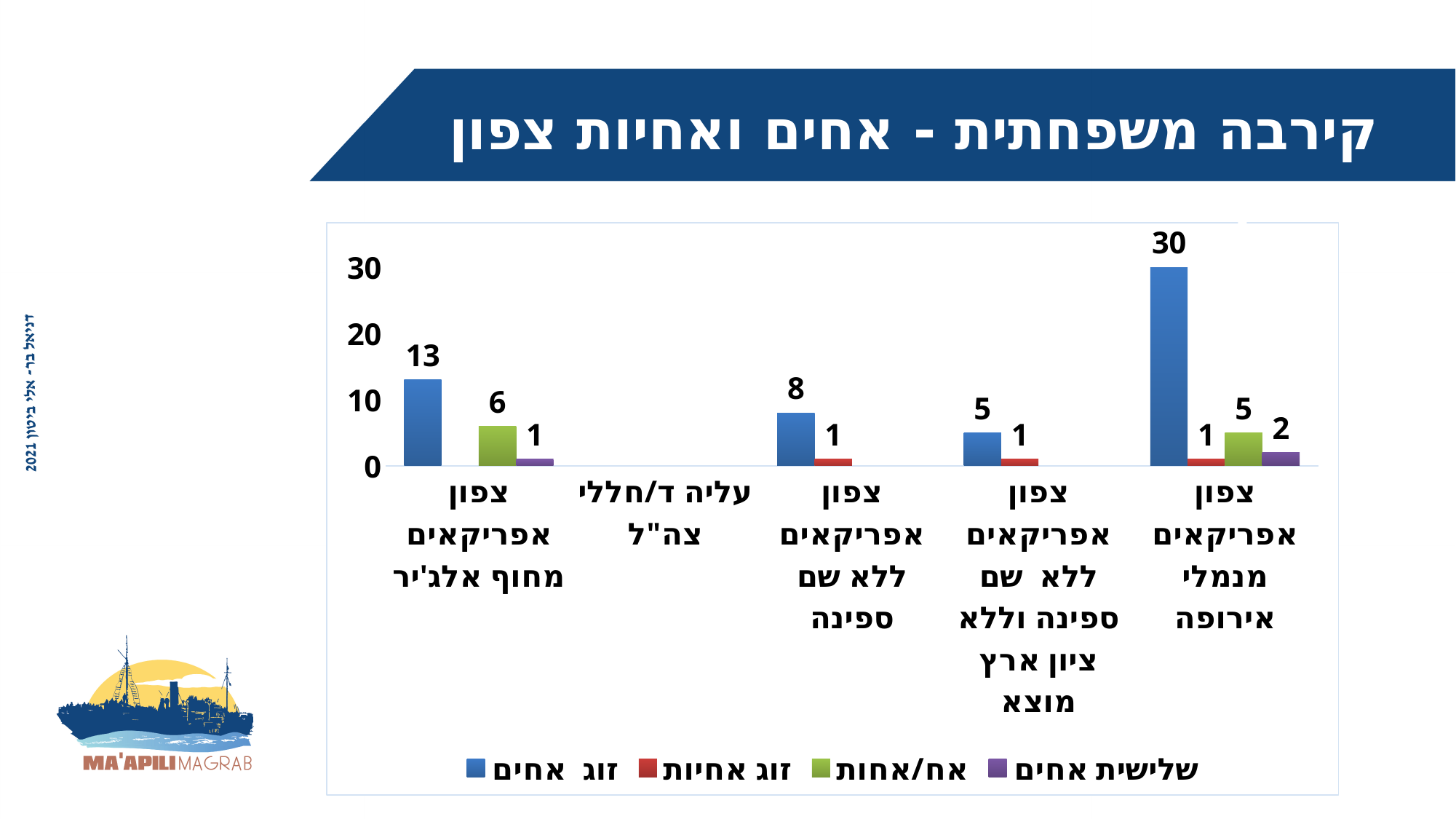
What is the value of אח/אחות for צפון אפריקאים מחוף אלג'יר? 6 What is the value of זוג אחים for צפון אפריקאים מחוף אלג'יר? 13 What is the value of שלישית אחים for צפון אפריקאים מנמלי אירופה? 2 Which is larger: זוג אחים for צפון אפריקאים ללא שם ספינה or זוג אחים for צפון אפריקאים ללא שם ספינה וללא ציון ארץ מוצא? צפון אפריקאים ללא שם ספינה Which category has the highest value for זוג אחים? צפון אפריקאים מנמלי אירופה How many categories are shown on the x axis? 5 Which category has no bars plotted at all? עליה ד/חללי צה"ל How many series does the legend list? 4 What is the value of זוג אחים for צפון אפריקאים מנמלי אירופה? 30 What type of chart is shown on the slide? bar chart What is the difference between the זוג אחים values for צפון אפריקאים מנמלי אירופה and צפון אפריקאים מחוף אלג'יר? 17 What colour represents the זוג אחיות series in the legend? red